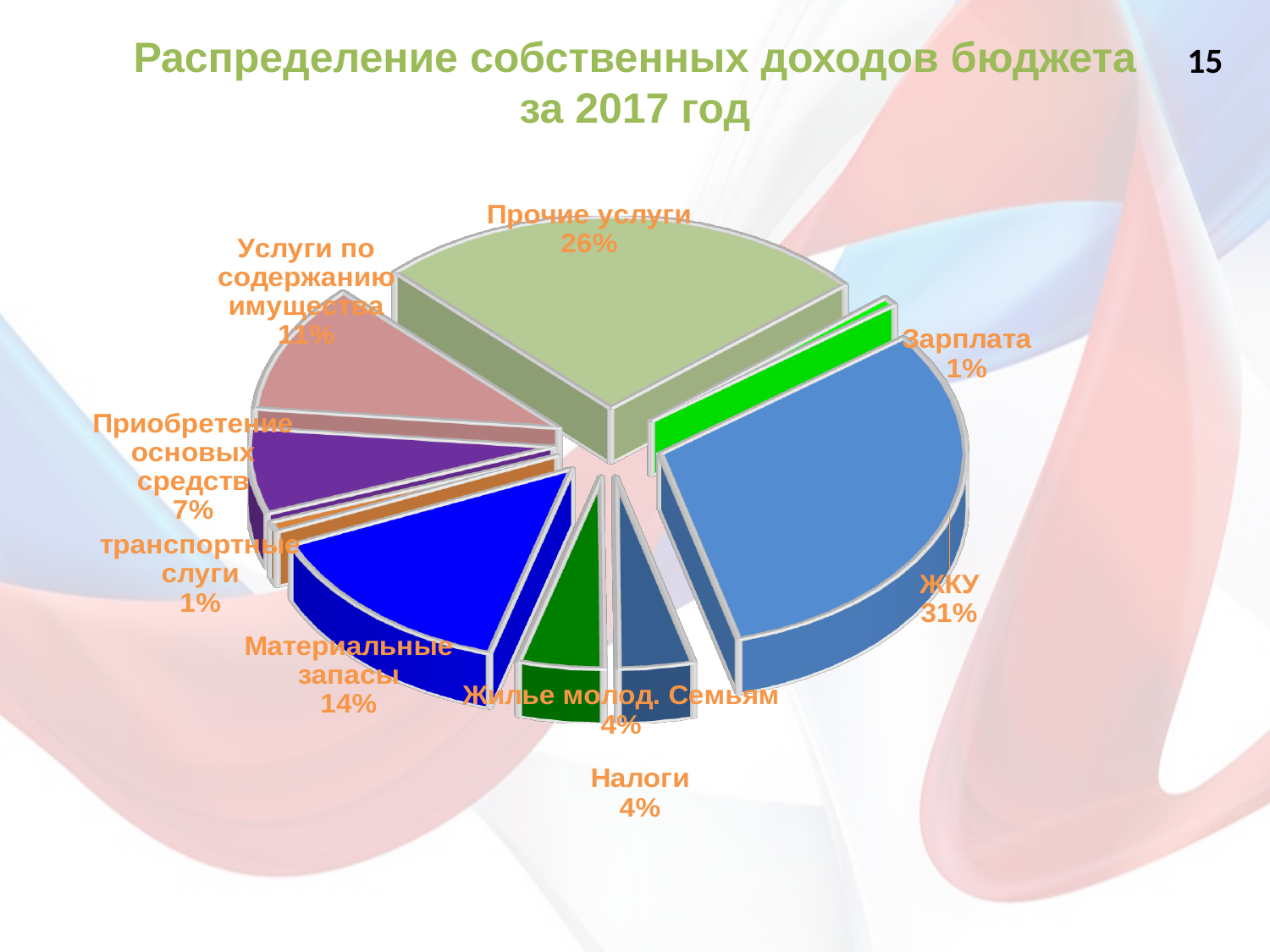
What share of the pie does ЖКУ take? 31% What is the value shown for Приобретение основных средств? 7% What kind of chart is shown on the slide? pie chart Which is larger, the share for Материальные запасы or the share for Услуги по содержанию имущества? Материальные запасы What is the title of the chart? Распределение собственных доходов бюджета за 2017 год What is the value shown for Материальные запасы? 14% What share of the pie does Прочие услуги take? 26% How many slices does the pie chart have? 9 What is the difference between the shares of ЖКУ and Прочие услуги? 5% Which category has the largest share of the pie? ЖКУ What is the value shown for Зарплата? 1% What is the value shown for Услуги по содержанию имущества? 11%